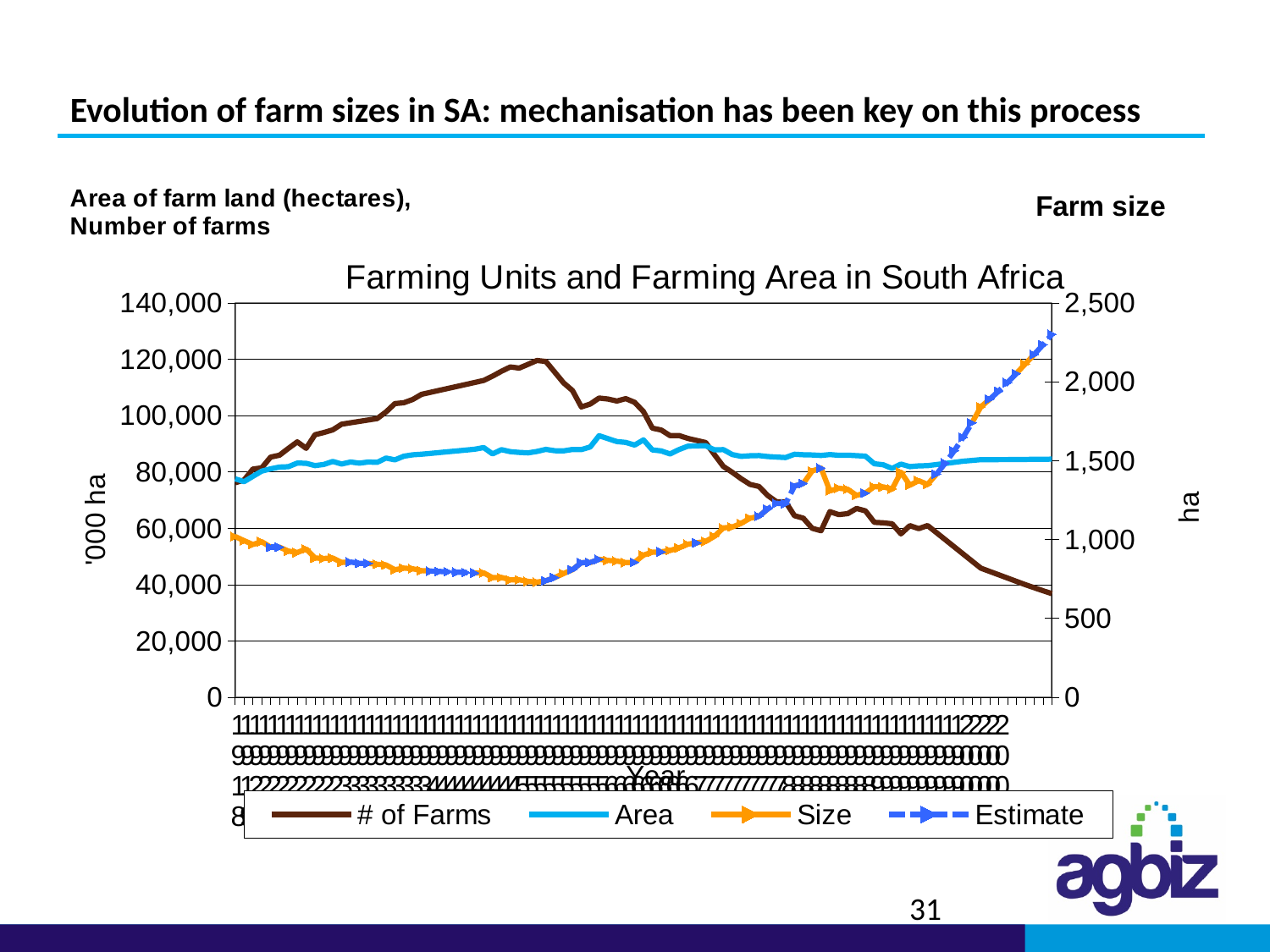
What are the four series named in the chart legend? # of Farms, Area, Size, Estimate How many series does the chart legend list? 4 Does the Estimate series rise or fall toward the right end of the chart? rise Is the lowest value of the Size series greater or less than 1,000 on the right axis? less What is the title of the chart? Farming Units and Farming Area in South Africa Does the # of Farms series rise or fall over the right-hand half of the chart? fall Which series reaches the highest value on the left axis? # of Farms At the right end of the chart, which series is higher on the left axis, Area or # of Farms? Area Is the peak value of the # of Farms series greater or less than 100,000 on the left axis? greater Is the highest value of the Estimate series greater or less than 2,000 on the right axis? greater What kind of chart is shown on the slide? line chart